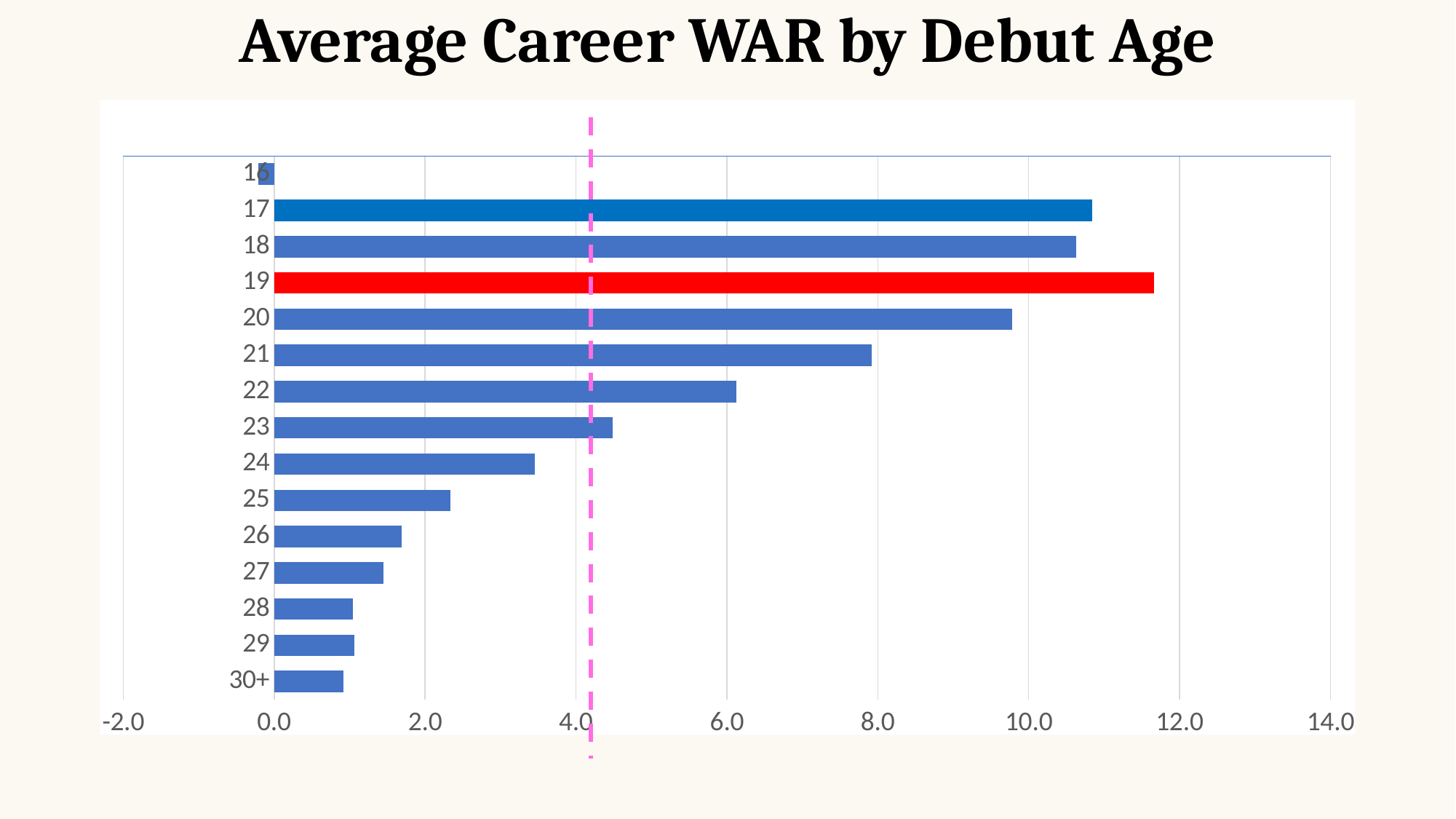
What kind of chart is shown on the slide? bar chart Do the values rise or fall as debut age increases from 19 to 30+? fall Which debut age has the lowest average career WAR? 16 Which debut age has the highest average career WAR? 19 Is the value for debut age 17 greater or less than 10.0? greater Is the value for debut age 24 greater or less than 2.0? greater What is the title of the chart? Average Career WAR by Debut Age How many debut age categories are plotted on the chart? 15 Which debut age is shown with a red bar? 19 Is the value for debut age 27 greater or less than 2.0? less Which has a higher average career WAR, debut age 20 or debut age 21? 20